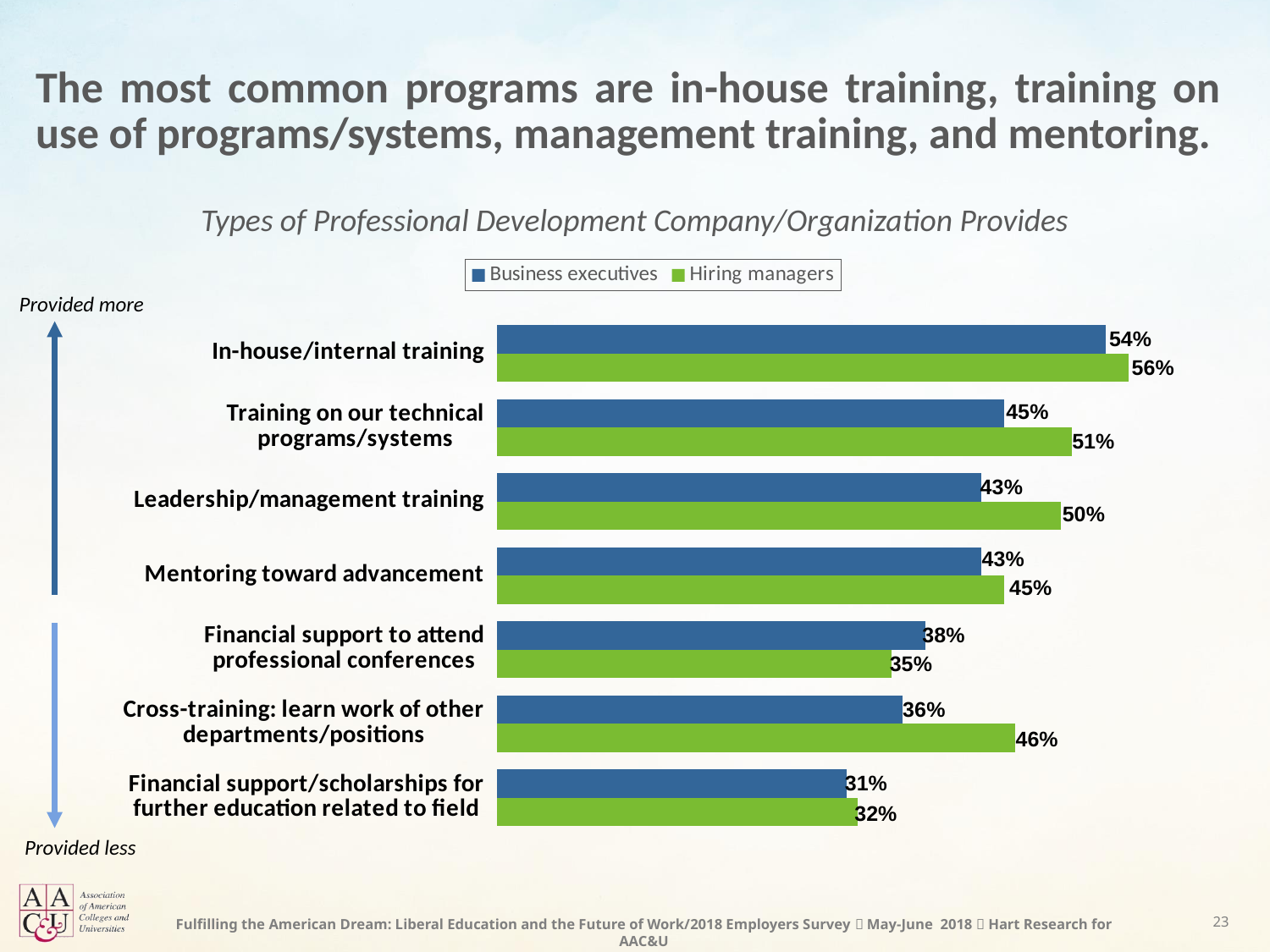
What is the title of the chart? Types of Professional Development Company/Organization Provides What percentage of hiring managers report providing leadership/management training? 50% What is the difference between hiring managers and business executives for cross-training: learn work of other departments/positions? 10 percentage points Which type of professional development has the highest value for hiring managers? In-house/internal training For financial support to attend professional conferences, which group reports a higher value: business executives or hiring managers? Business executives Which type of professional development has the lowest value for business executives? Financial support/scholarships for further education related to field What kind of chart is shown on the slide? Bar chart What percentage of business executives report providing in-house/internal training? 54% How many series does the legend list? 2 What percentage of hiring managers report providing cross-training: learn work of other departments/positions? 46% What is the difference between hiring managers and business executives for training on our technical programs/systems? 6 percentage points How many types of professional development are shown in the chart? 7